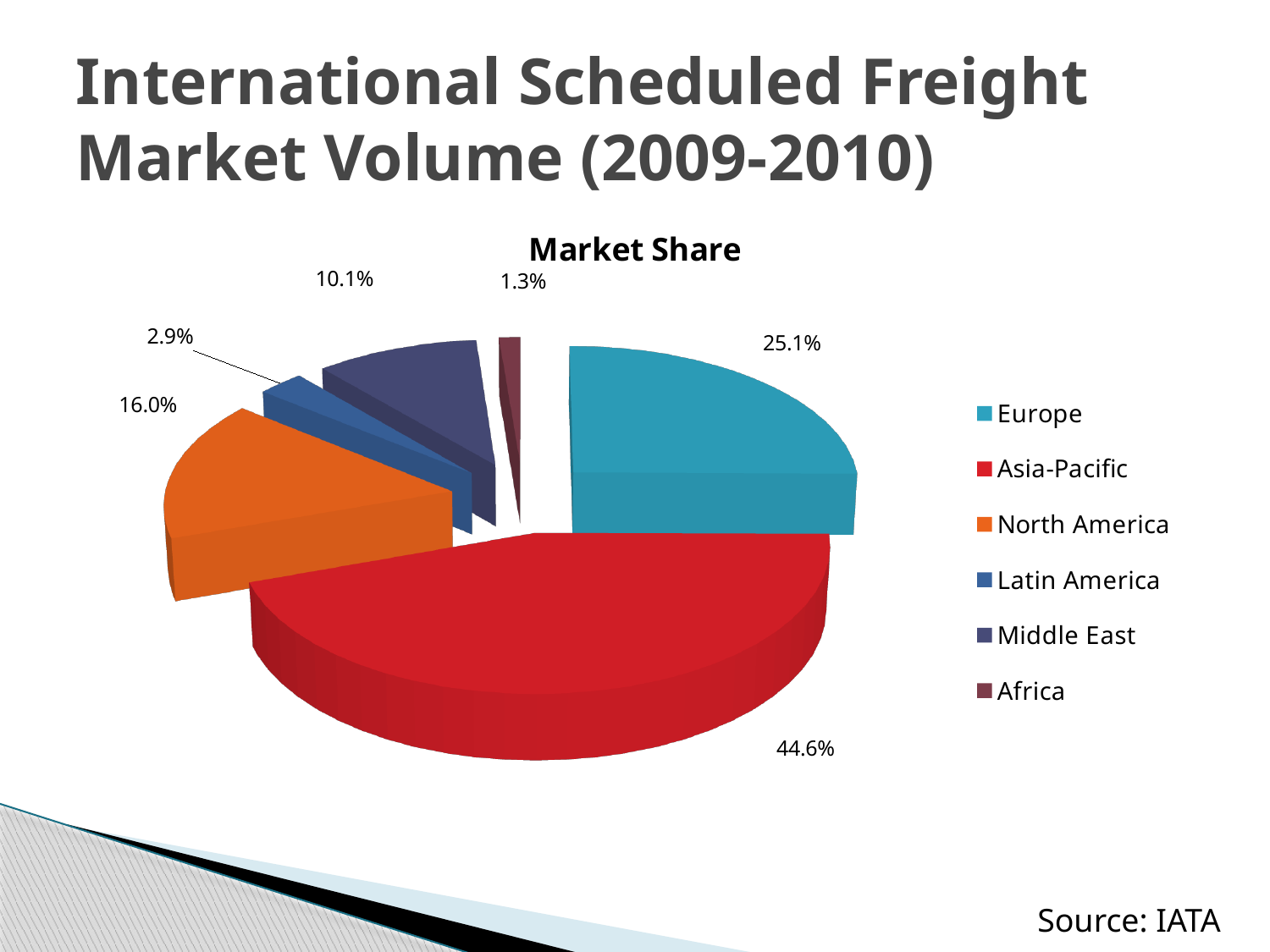
What is the market share for Asia-Pacific? 44.6% What type of chart is shown on the slide? Pie chart What is the title of the pie chart? Market Share Which has a larger market share, North America or Middle East? North America What is the difference in market share between Asia-Pacific and Europe? 19.5% How many regions are shown in the pie chart? 6 What is the market share for North America? 16.0% What is the market share for Middle East? 10.1% Which region has the smallest market share? Africa What is the market share for Africa? 1.3% Which region has the largest market share? Asia-Pacific What is the market share for Europe? 25.1%